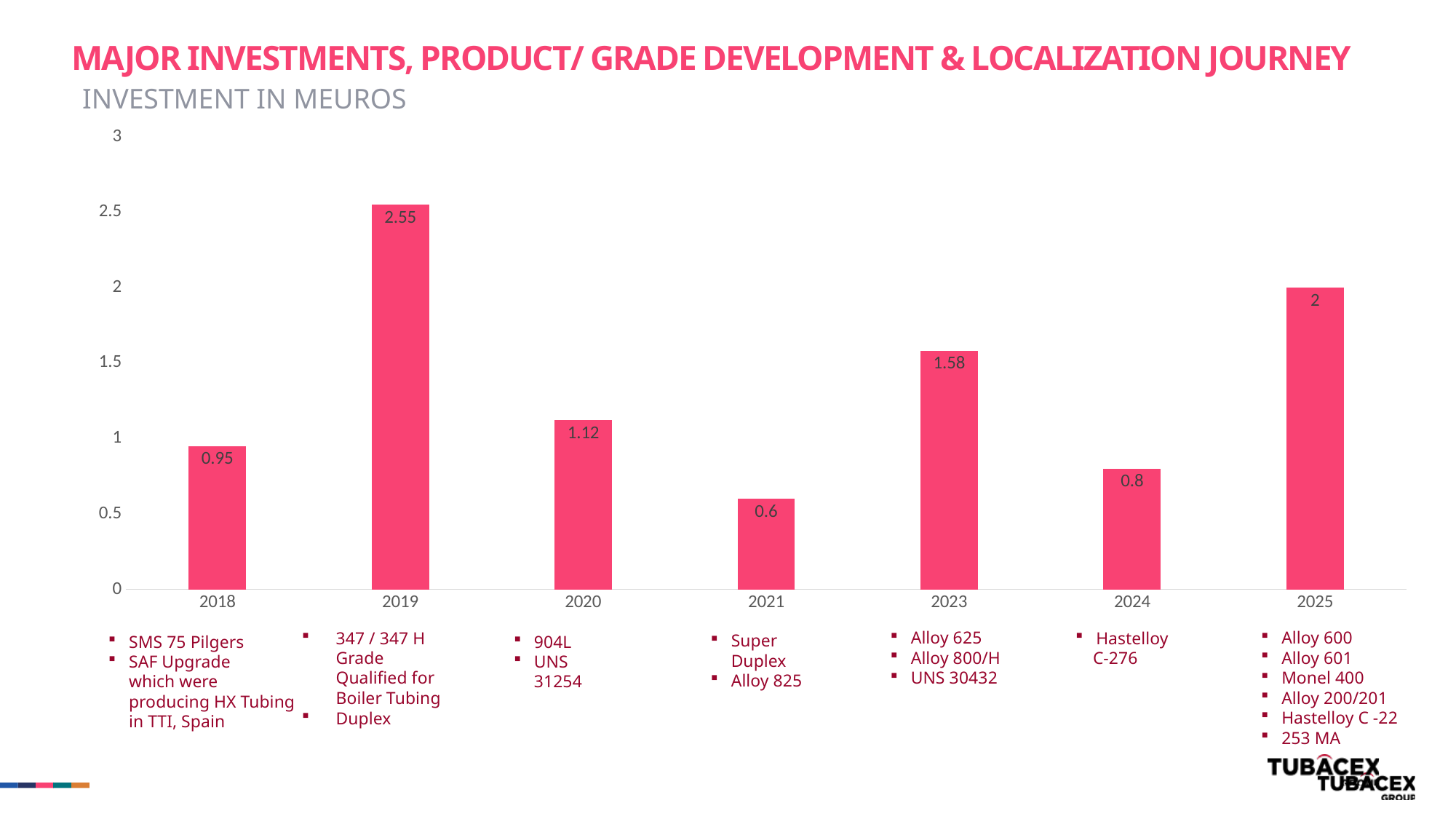
What is the difference between the investment in 2019 and the investment in 2025? 0.55 Is the value for 2018 greater or less than 1? less Does the investment rise or fall from 2023 to 2024? fall What is the investment value for 2019? 2.55 What is the investment value for 2021? 0.6 What is the investment value for 2024? 0.8 What kind of chart is shown on the slide? bar chart How many years are shown on the x axis of the chart? 7 Which year has the lowest investment? 2021 What is the subtitle shown above the chart? INVESTMENT IN MEUROS Which is larger, the investment in 2020 or the investment in 2023? 2023 Which year has the highest investment? 2019